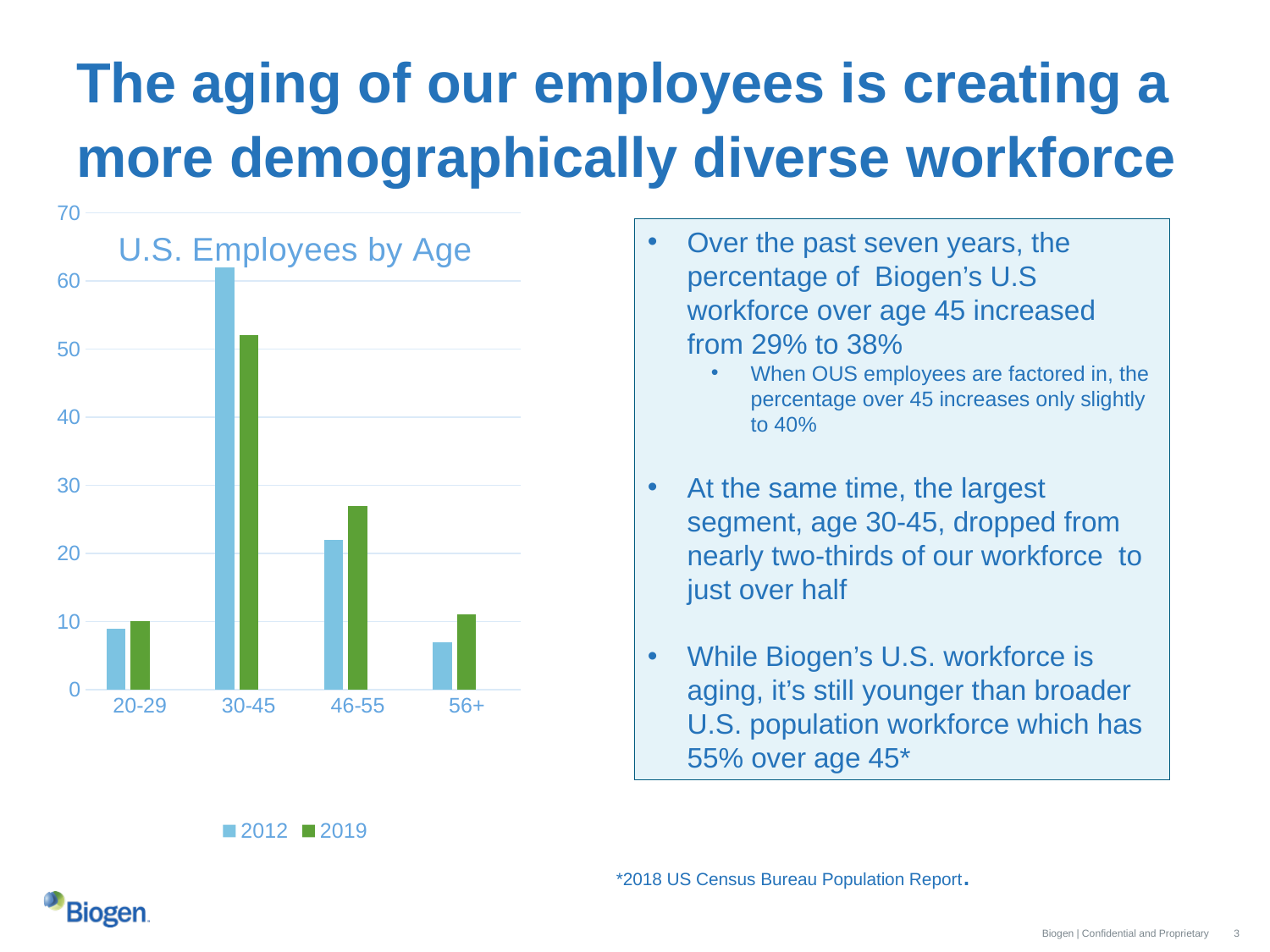
Which age group has the highest value for 2012? 30-45 How many age categories are shown on the x axis of the chart? 4 For the 30-45 age group, which year has the larger value, 2012 or 2019? 2012 What kind of chart is shown on the slide? bar chart Which age group has the lowest value for 2012? 56+ Is the 2012 value for the 30-45 age group greater or less than 60? greater What is the title of the chart? U.S. Employees by Age Which colour represents the 2019 series in the chart? green For the 46-55 age group, which year has the larger value, 2012 or 2019? 2019 Is the 2019 value for the 46-55 age group greater or less than 30? less How many series does the chart's legend list? 2 Which age group has the lowest value for 2019? 20-29